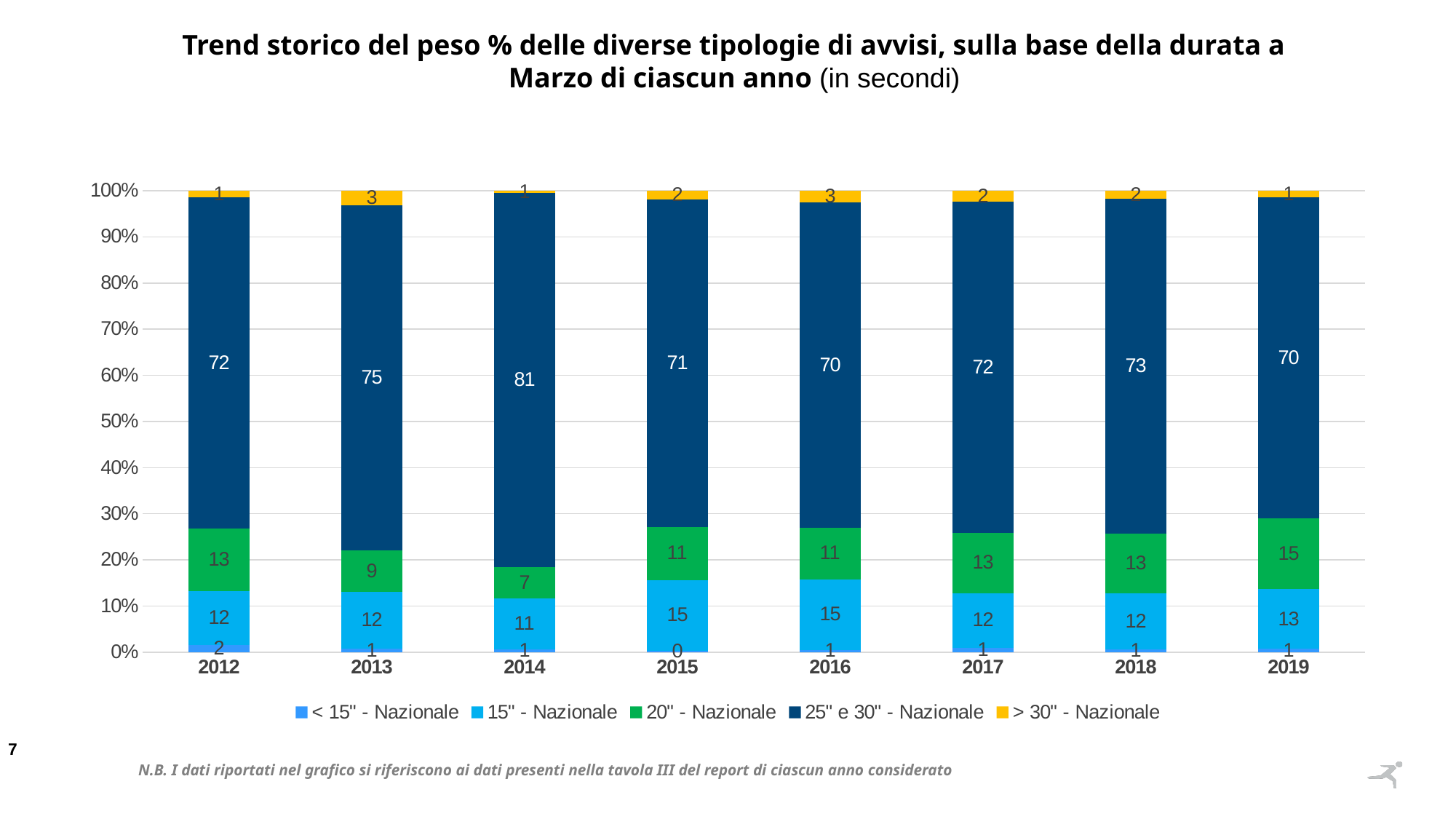
How many series does the legend list? 5 Which colour represents the > 30'' - Nazionale series? Yellow In which year is the 20'' - Nazionale series lowest? 2014 What is the value for the 20'' - Nazionale series in 2019? 15 What is the value for the 25'' e 30'' - Nazionale series in 2014? 81 What is the value for the > 30'' - Nazionale series in 2013? 3 Which is larger, the 20'' - Nazionale value in 2013 or in 2017? 2017 In which year is the 25'' e 30'' - Nazionale series highest? 2014 How many years are shown on the x axis? 8 What is the difference between the 25'' e 30'' - Nazionale values for 2014 and 2019? 11 What kind of chart is shown on the slide? Stacked bar chart What is the value for the 15'' - Nazionale series in 2016? 15